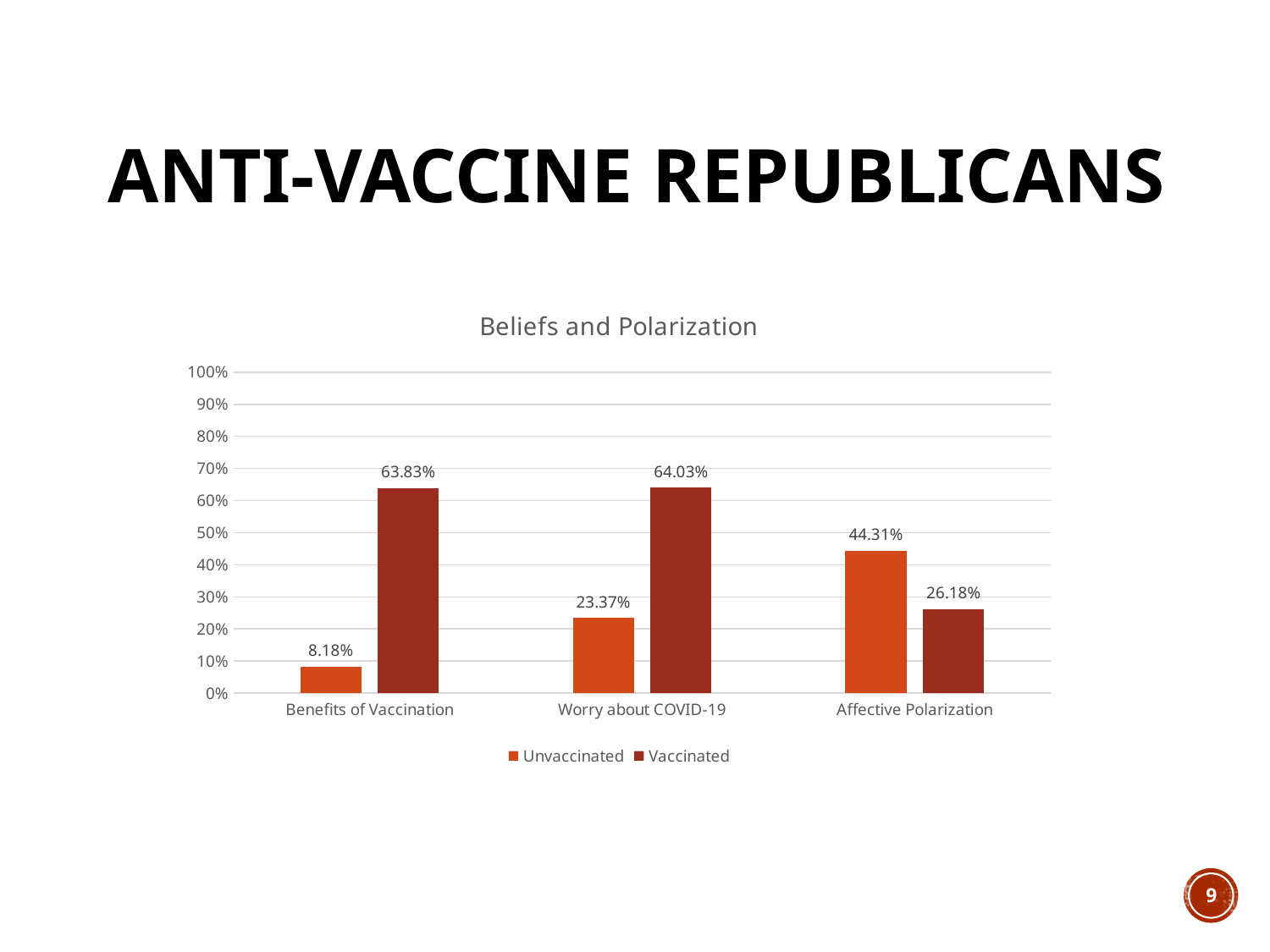
Which category has the lowest Unvaccinated value? Benefits of Vaccination How many categories are shown on the x axis? 3 What is the difference between the Vaccinated and Unvaccinated values for Benefits of Vaccination? 55.65% For Worry about COVID-19, which series has the larger value, Unvaccinated or Vaccinated? Vaccinated What is the Unvaccinated value for Affective Polarization? 44.31% What is the difference between the Unvaccinated and Vaccinated values for Affective Polarization? 18.13% Which category has the lowest Vaccinated value? Affective Polarization What is the Unvaccinated value for Benefits of Vaccination? 8.18% How many series does the legend list? 2 What is the title of the chart? Beliefs and Polarization What is the Vaccinated value for Affective Polarization? 26.18% What is the Vaccinated value for Worry about COVID-19? 64.03%